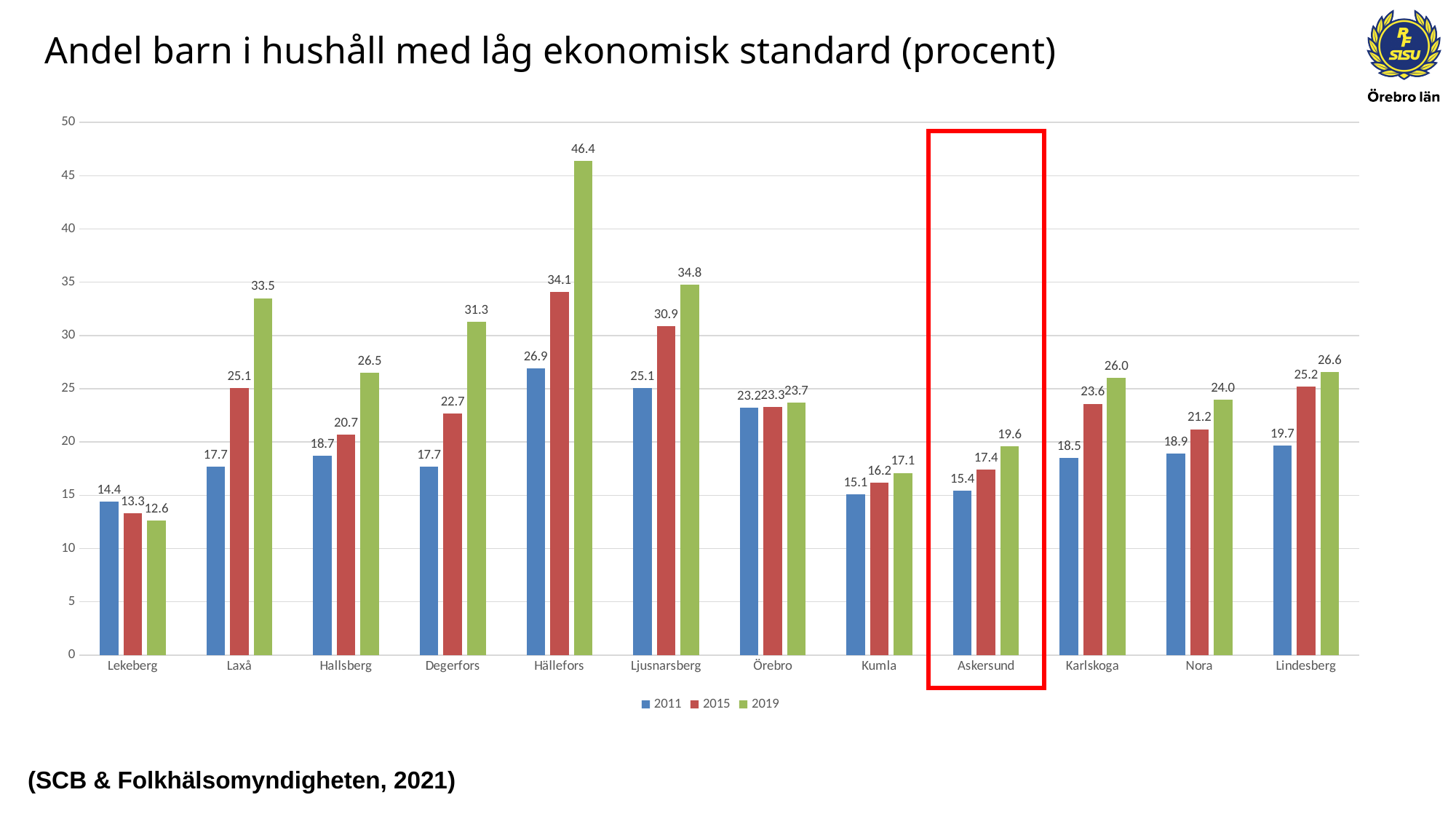
Which municipality has the lowest value in 2019? Lekeberg Which is larger, the 2019 value for Ljusnarsberg or the 2019 value for Degerfors? Ljusnarsberg How many series does the legend list? 3 What is the value for Lekeberg in 2011? 14.4 How many municipalities are shown on the x axis? 12 What is the value for Hällefors in 2019? 46.4 What is the value for Askersund in 2015? 17.4 What is the difference between the 2019 and 2011 values for Laxå? 15.8 What kind of chart is shown on the slide? bar chart Which municipality is highlighted with a red box on the chart? Askersund Do the values for Lekeberg rise or fall from 2011 to 2019? fall Which municipality has the highest value in 2019? Hällefors